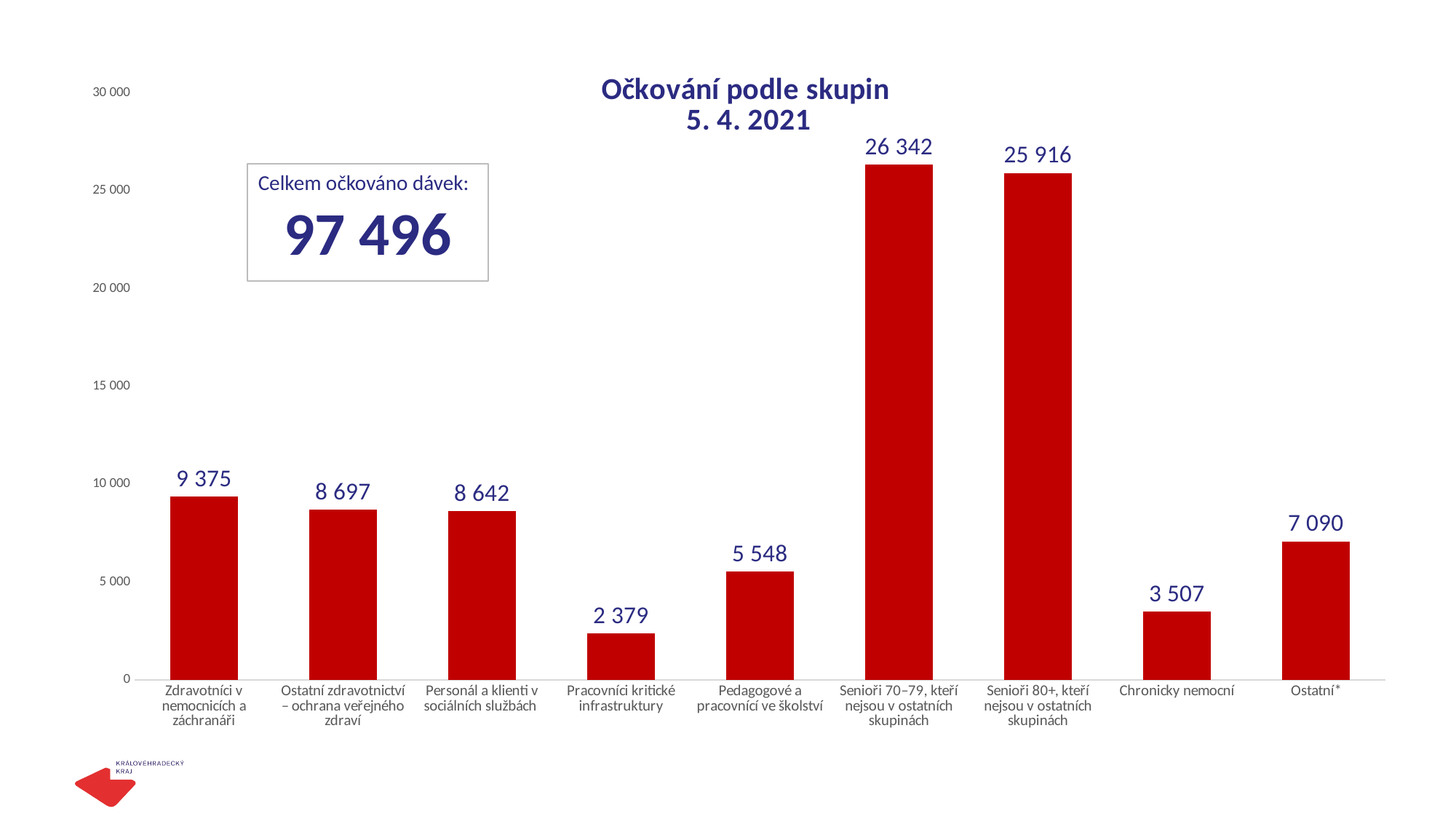
Which category has the lowest value? Pracovníci kritické infrastruktury What is the difference between the values for Senioři 70–79 and Senioři 80+? 426 What kind of chart is shown on the slide? bar chart Which category has the highest value? Senioři 70–79, kteří nejsou v ostatních skupinách Is the value for Pedagogové a pracovníci ve školství greater or less than 5 000? greater What is the value for Pedagogové a pracovníci ve školství? 5 548 What is the difference between the values for Ostatní* and Chronicky nemocní? 3 583 How many categories are shown on the x axis? 9 What is the value for Zdravotníci v nemocnicích a záchranáři? 9 375 Which is larger: the value for Ostatní* or the value for Pedagogové a pracovníci ve školství? Ostatní* What total number of doses is shown in the box on the slide (Celkem očkováno dávek)? 97 496 What is the value for Chronicky nemocní? 3 507